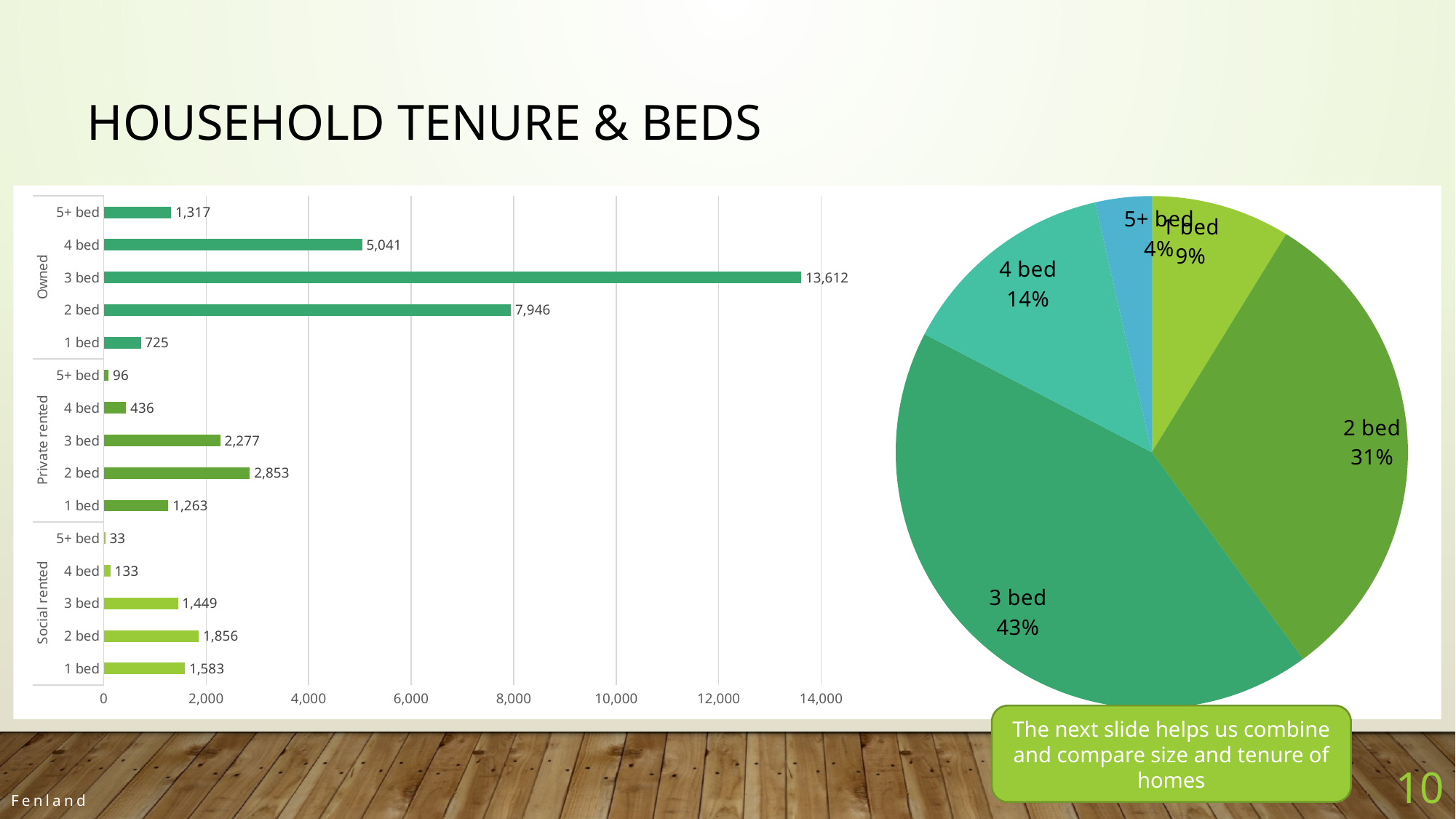
In the pie chart on the right, what share do 4 bed homes have? 14% In the bar chart on the left, which category has the lowest value? Social rented 5+ bed In the pie chart on the right, what share do 3 bed homes have? 43% In the bar chart on the left, what is the value for 1 bed homes in the Social rented group? 1,583 In the bar chart on the left, what is the value for 2 bed homes in the Private rented group? 2,853 How many slices does the pie chart on the right have? 5 In the bar chart on the left, what is the value for 3 bed homes in the Owned group? 13,612 How many bars are plotted in the bar chart on the left? 15 What kind of chart is shown on the left of the slide? Bar chart In the bar chart on the left, which is larger: Private rented 3 bed or Social rented 2 bed? Private rented 3 bed In the bar chart on the left, what is the difference between Owned 2 bed and Owned 4 bed? 2,905 In the bar chart on the left, which category has the highest value? Owned 3 bed